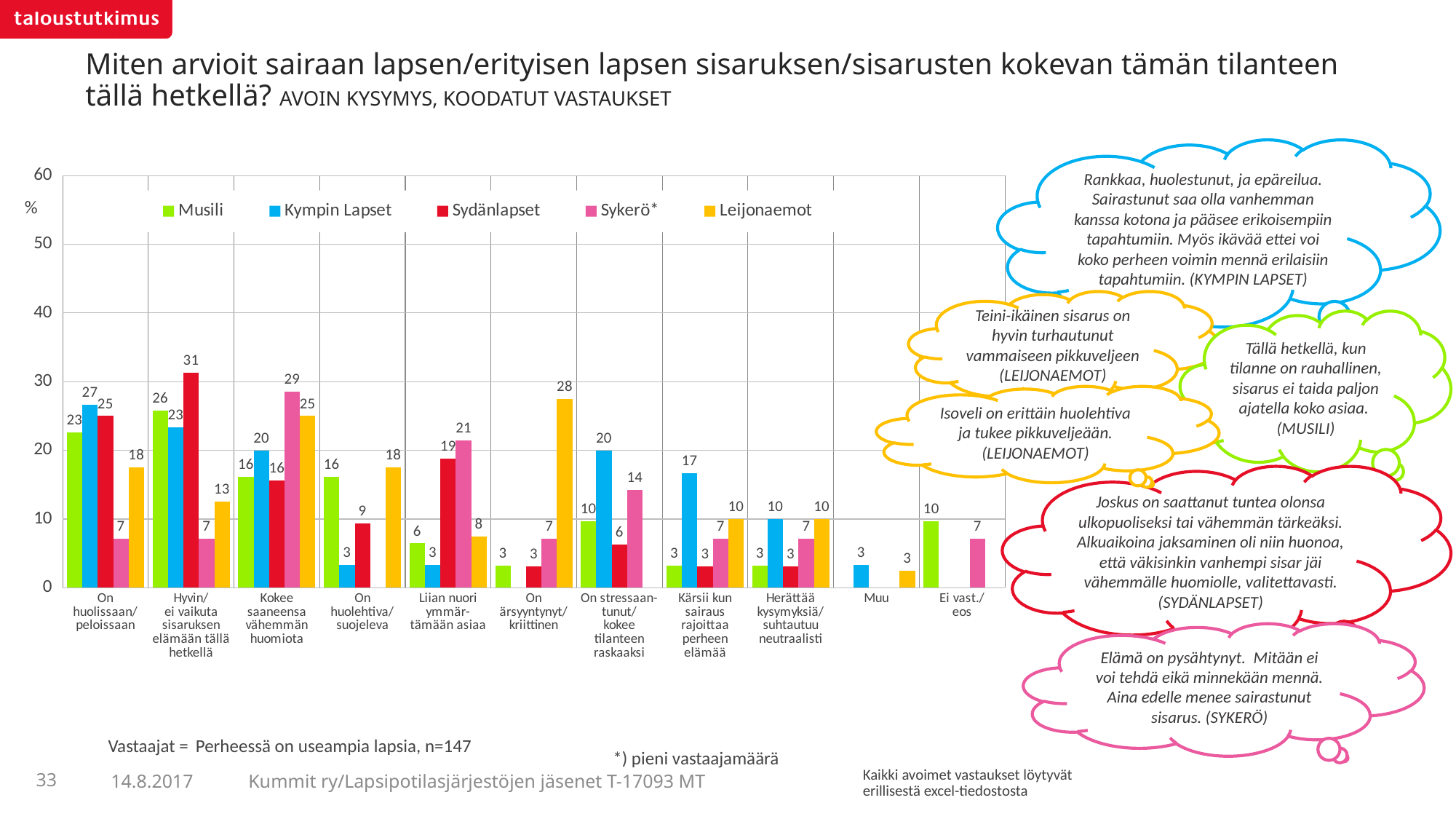
What is the value for Sydänlapset in the category "Hyvin/ei vaikuta sisaruksen elämään tällä hetkellä"? 31 Which series has the lowest value in the category "On huolissaan/peloissaan"? Sykerö* What is the value for Kympin Lapset in the category "Kärsii kun sairaus rajoittaa perheen elämää"? 17 What is the value for Sykerö* in the category "Kokee saaneensa vähemmän huomiota"? 29 How many categories are shown on the x axis of the chart? 11 In the category "Hyvin/ei vaikuta sisaruksen elämään tällä hetkellä", which is larger: Musili or Kympin Lapset? Musili What colour represents Leijonaemot in the chart legend? Yellow What kind of chart is shown on the slide? Bar chart What is the difference between the Kympin Lapset and Sykerö* values in the category "On huolissaan/peloissaan"? 20 Which series has the highest value in the category "On huolissaan/peloissaan"? Kympin Lapset How many series does the legend list? 5 What is the value for Leijonaemot in the category "On ärsyyntynyt/kriittinen"? 28